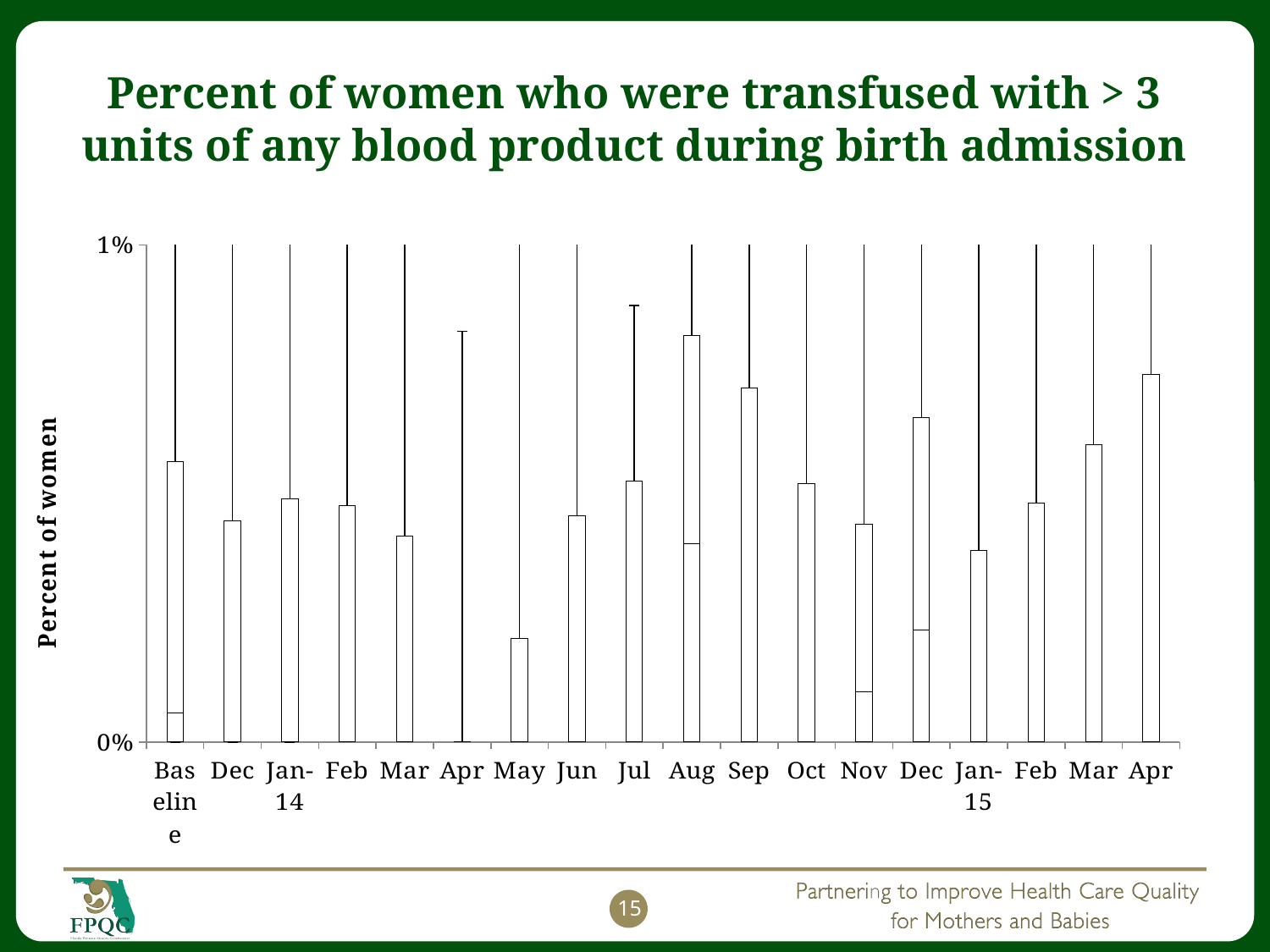
Is the top of the upper whisker for Jul greater or less than 1%? less What is the title of the chart? Percent of women who were transfused with > 3 units of any blood product during birth admission What kind of chart is shown on the slide? box-and-whisker plot Is the top of the box for Sep higher or lower than the top of the box for Nov? higher What is the lowest value shown on the y axis? 0% Which month has the highest top of its box? Aug How many categories are shown along the x axis of the chart? 18 What is the highest value shown on the y axis? 1% What is the label on the y axis of the chart? Percent of women What is the first category on the x axis? Baseline Is the top of the box for Aug higher or lower than the top of the box for May? higher Is the top of the upper whisker for Apr (2014) greater or less than 1%? less